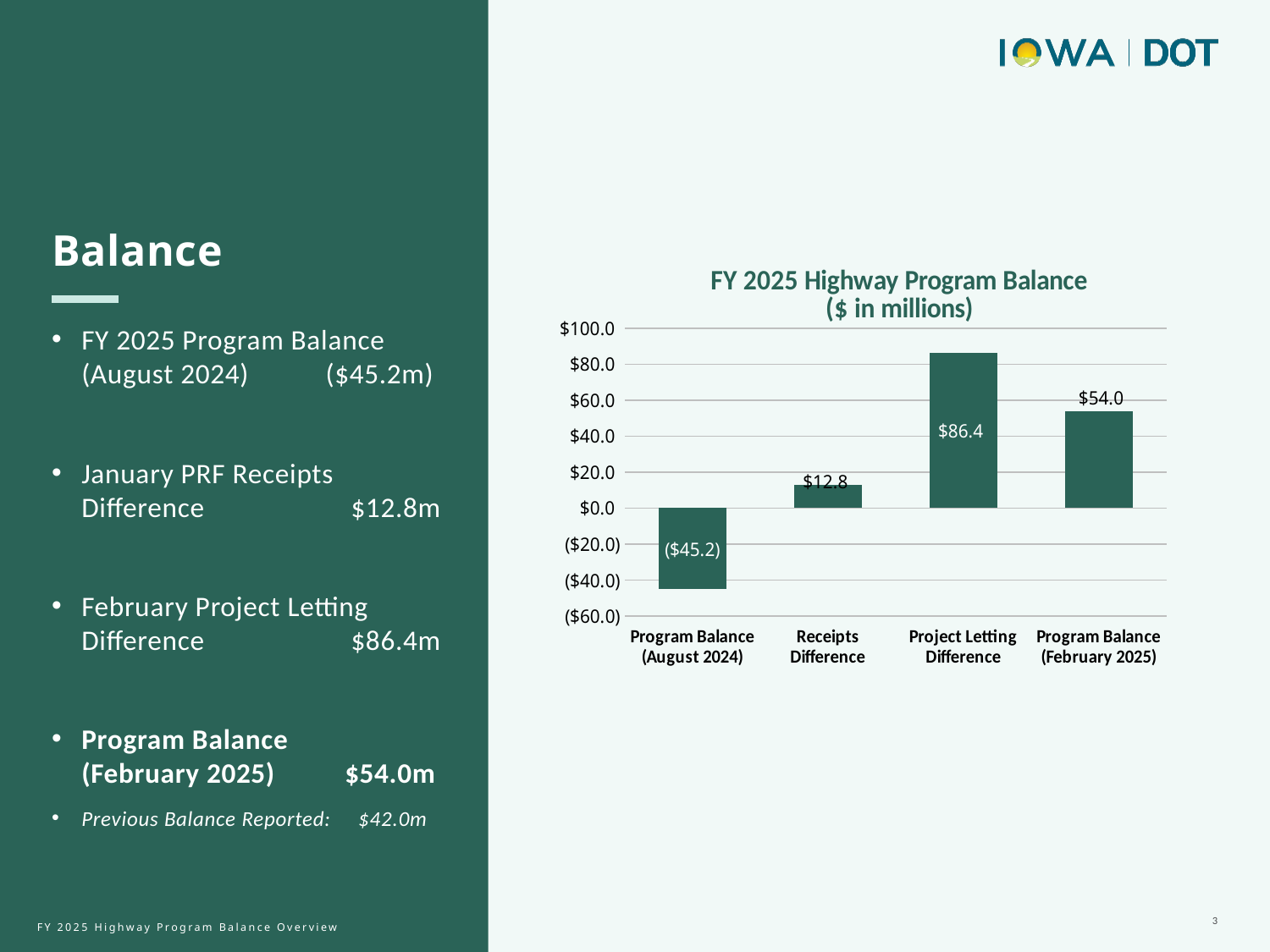
Is the value for Project Letting Difference greater or less than $80.0? greater What is the difference between the Project Letting Difference and the Program Balance (February 2025) values? $32.4 What is the value for Receipts Difference in the chart? $12.8 What is the value for Project Letting Difference in the chart? $86.4 Which category has the lowest value in the chart? Program Balance (August 2024) How many categories are shown in the chart? 4 What is the value for Program Balance (August 2024) in the chart? ($45.2) Which is larger, the Receipts Difference or the Program Balance (February 2025)? Program Balance (February 2025) What is the title of the chart? FY 2025 Highway Program Balance ($ in millions) Which category has the highest value in the chart? Project Letting Difference What kind of chart is shown on the slide? Bar chart What is the value for Program Balance (February 2025) in the chart? $54.0